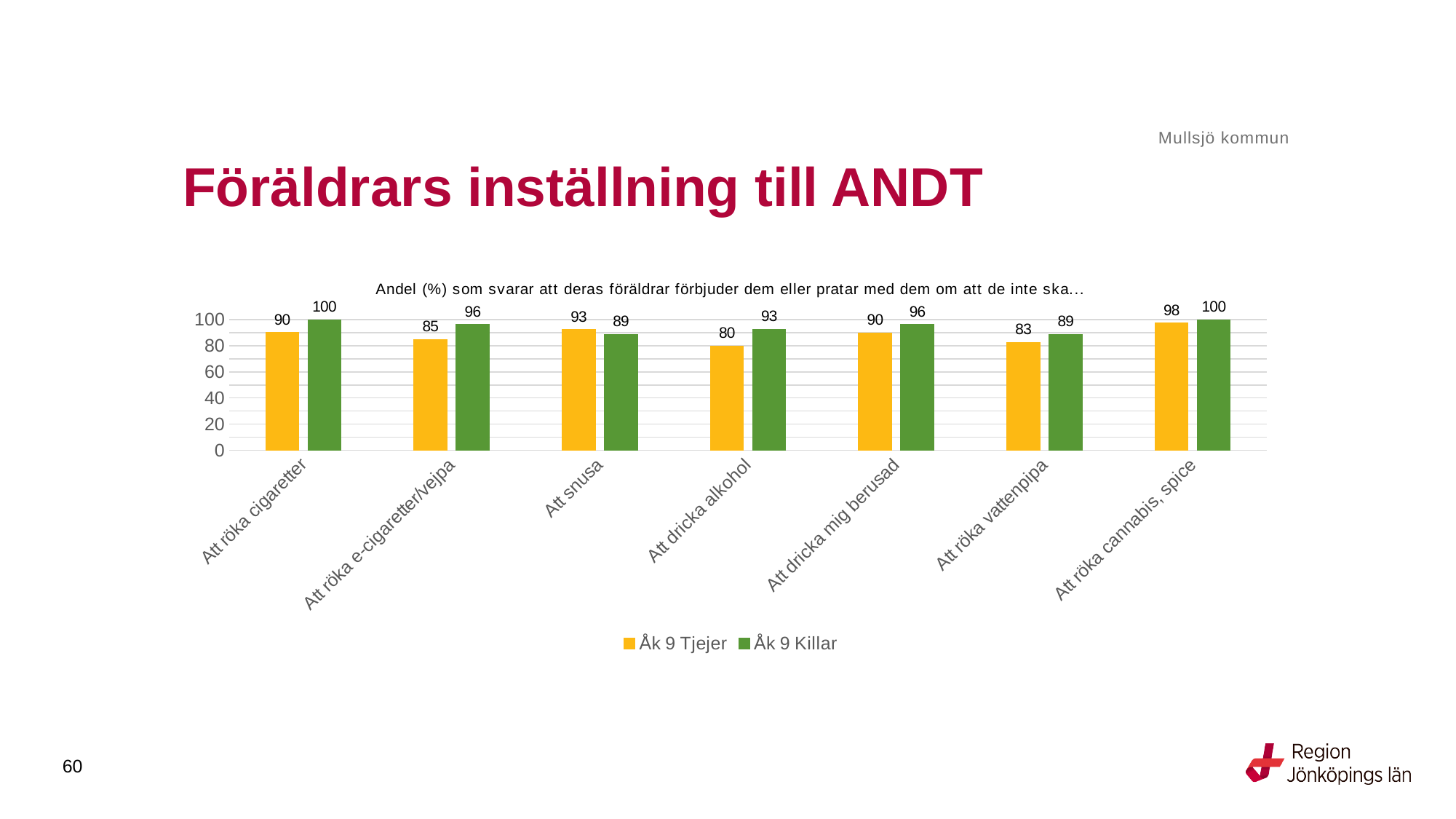
Which is larger for 'Att snusa': Åk 9 Tjejer or Åk 9 Killar? Åk 9 Tjejer What kind of chart is shown on the slide? Bar chart What is the value for Åk 9 Tjejer for 'Att röka cannabis, spice'? 98 What is the value for Åk 9 Killar for 'Att röka vattenpipa'? 89 Which category has the lowest value for Åk 9 Tjejer? Att dricka alkohol What is the value for Åk 9 Killar for 'Att röka e-cigaretter/vejpa'? 96 What is the value for Åk 9 Tjejer for 'Att dricka alkohol'? 80 How many categories are shown on the x axis? 7 How many series does the legend list? 2 What is the difference between Åk 9 Killar and Åk 9 Tjejer for 'Att dricka alkohol'? 13 Which category has the highest value for Åk 9 Tjejer? Att röka cannabis, spice Which colour represents Åk 9 Killar in the chart? Green